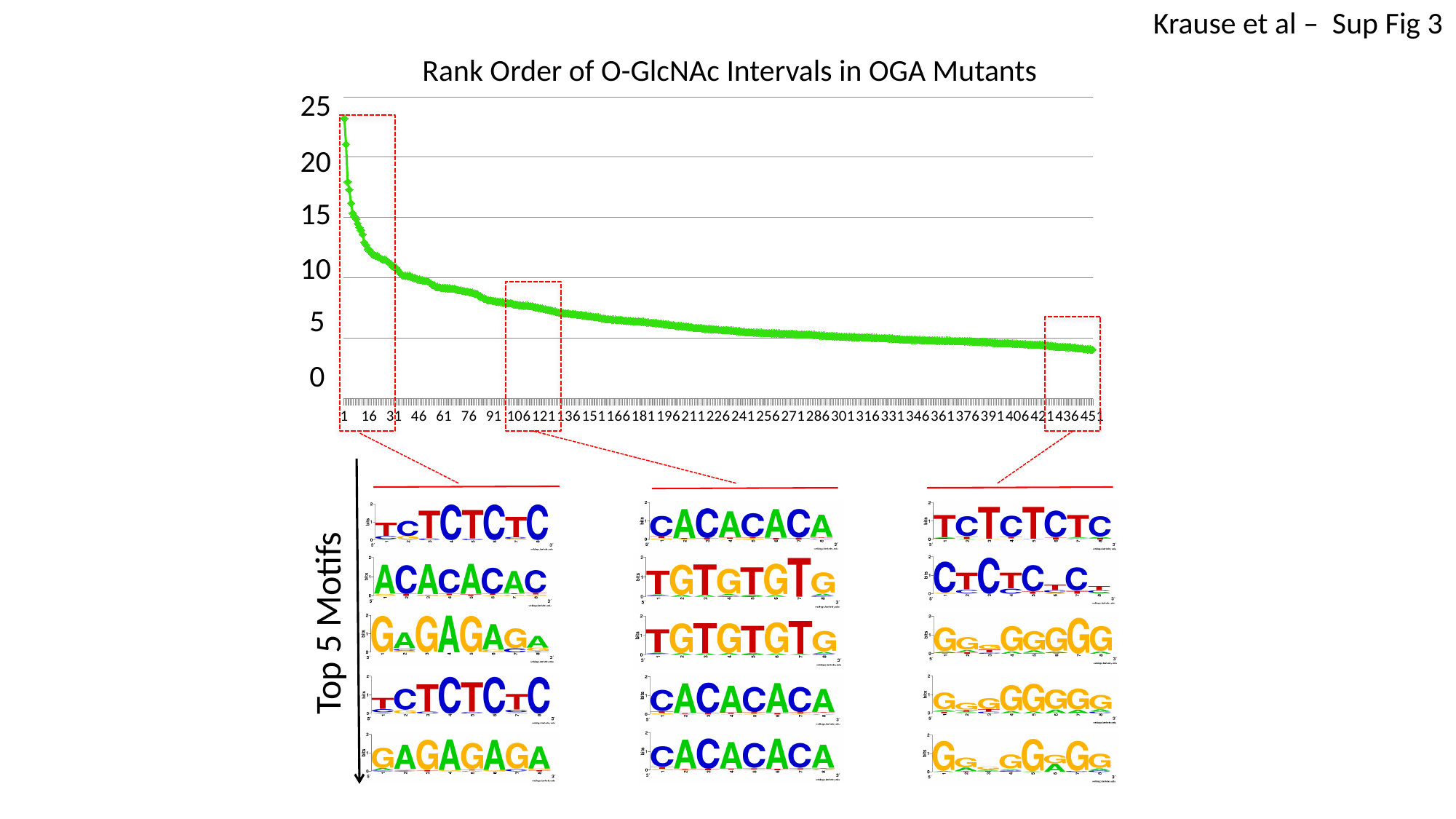
What is the title of the chart? Rank Order of O-GlcNAc Intervals in OGA Mutants Which rank has the highest plotted value? 1 Is the value at rank 241 greater or less than 10? less Is the value at rank 106 greater or less than 5? greater Do the plotted values rise or fall as the rank increases along the x axis? fall Is the value at rank 1 greater or less than 20? greater What kind of chart is shown on the slide? line chart Which is larger, the value at rank 1 or the value at rank 451? rank 1 What is the highest tick value shown on the y axis? 25